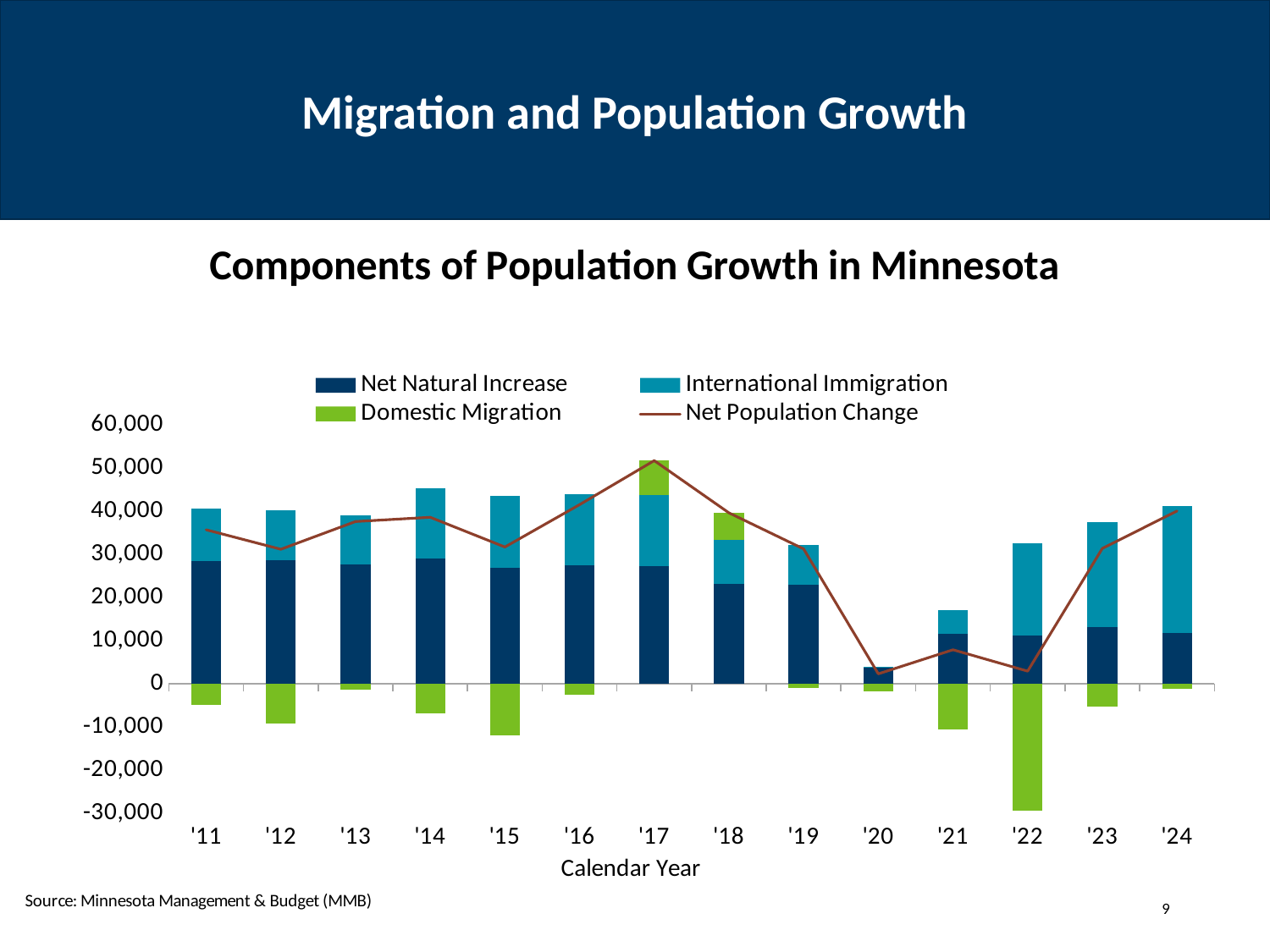
Is the Domestic Migration value for '22 greater or less than -20,000? less Is the Net Population Change for '17 greater or less than 40,000? greater What kind of chart is shown on the slide? Stacked bar chart with a line How many years are shown on the x axis of the chart? 14 Does the Net Population Change line rise or fall from '22 to '24? rise How many series does the chart legend list? 4 What is the title of the x axis? Calendar Year Which year has the larger Net Population Change, '17 or '20? '17 In which year is Net Natural Increase lowest? '20 Is the Net Population Change for '20 greater or less than 10,000? less In which year is the Net Population Change line at its highest? '17 In which year is Domestic Migration most negative? '22